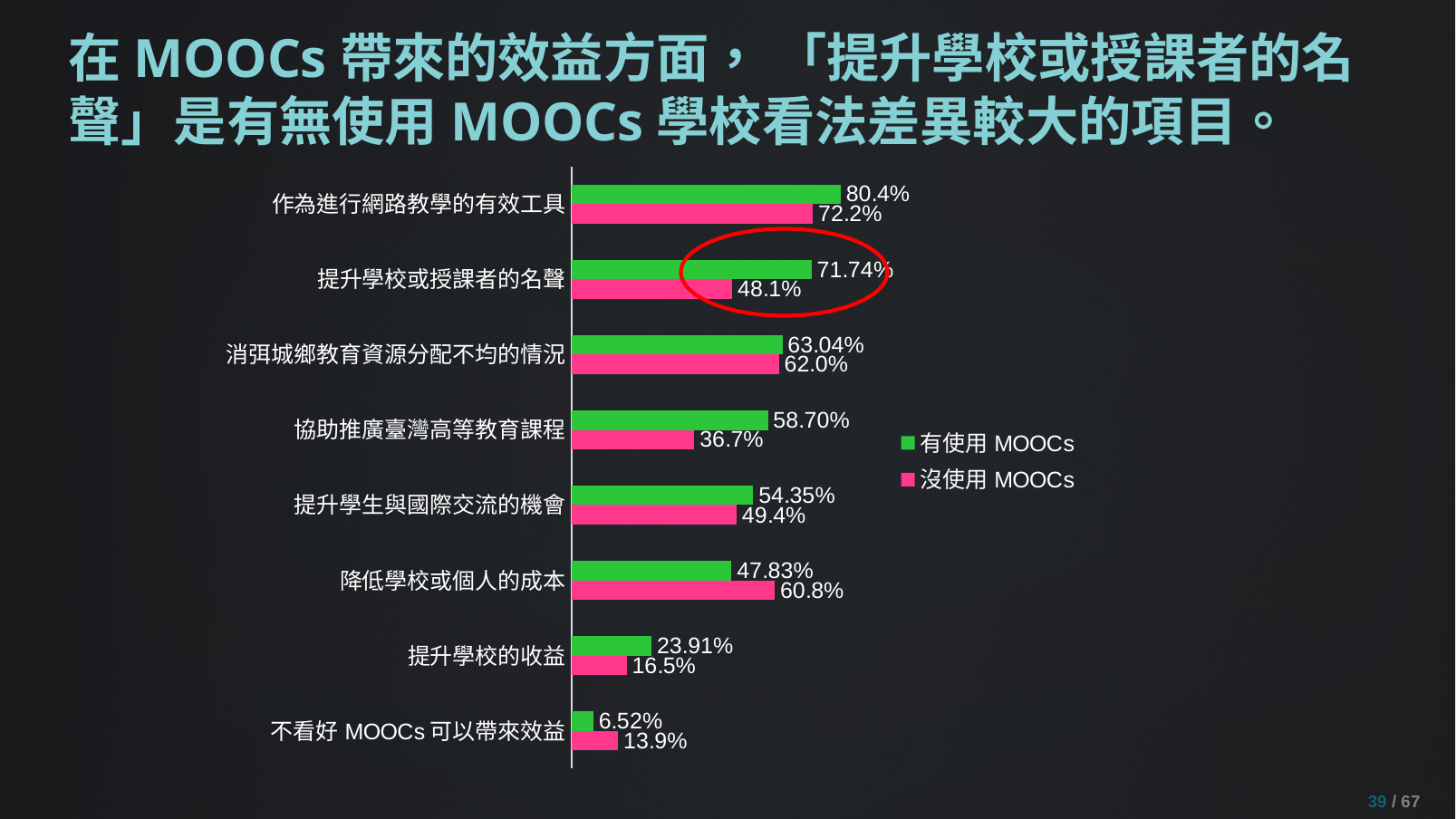
What kind of chart is shown on the slide? bar chart Which category has the lowest value for 沒使用 MOOCs? 不看好 MOOCs 可以帶來效益 What is the value for 沒使用 MOOCs in the category 不看好 MOOCs 可以帶來效益? 13.9% What is the difference between the 有使用 MOOCs and 沒使用 MOOCs values for 提升學校或授課者的名聲? 23.64 percentage points What is the value for 有使用 MOOCs in the category 作為進行網路教學的有效工具? 80.4% What is the value for 有使用 MOOCs in the category 降低學校或個人的成本? 47.83% How many categories are plotted in the chart? 8 Which category has the highest value for 有使用 MOOCs? 作為進行網路教學的有效工具 How many series does the legend list? 2 Which colour represents the 沒使用 MOOCs series in the chart? pink What is the value for 沒使用 MOOCs in the category 提升學校或授課者的名聲? 48.1% For 降低學校或個人的成本, which series has the larger value, 有使用 MOOCs or 沒使用 MOOCs? 沒使用 MOOCs